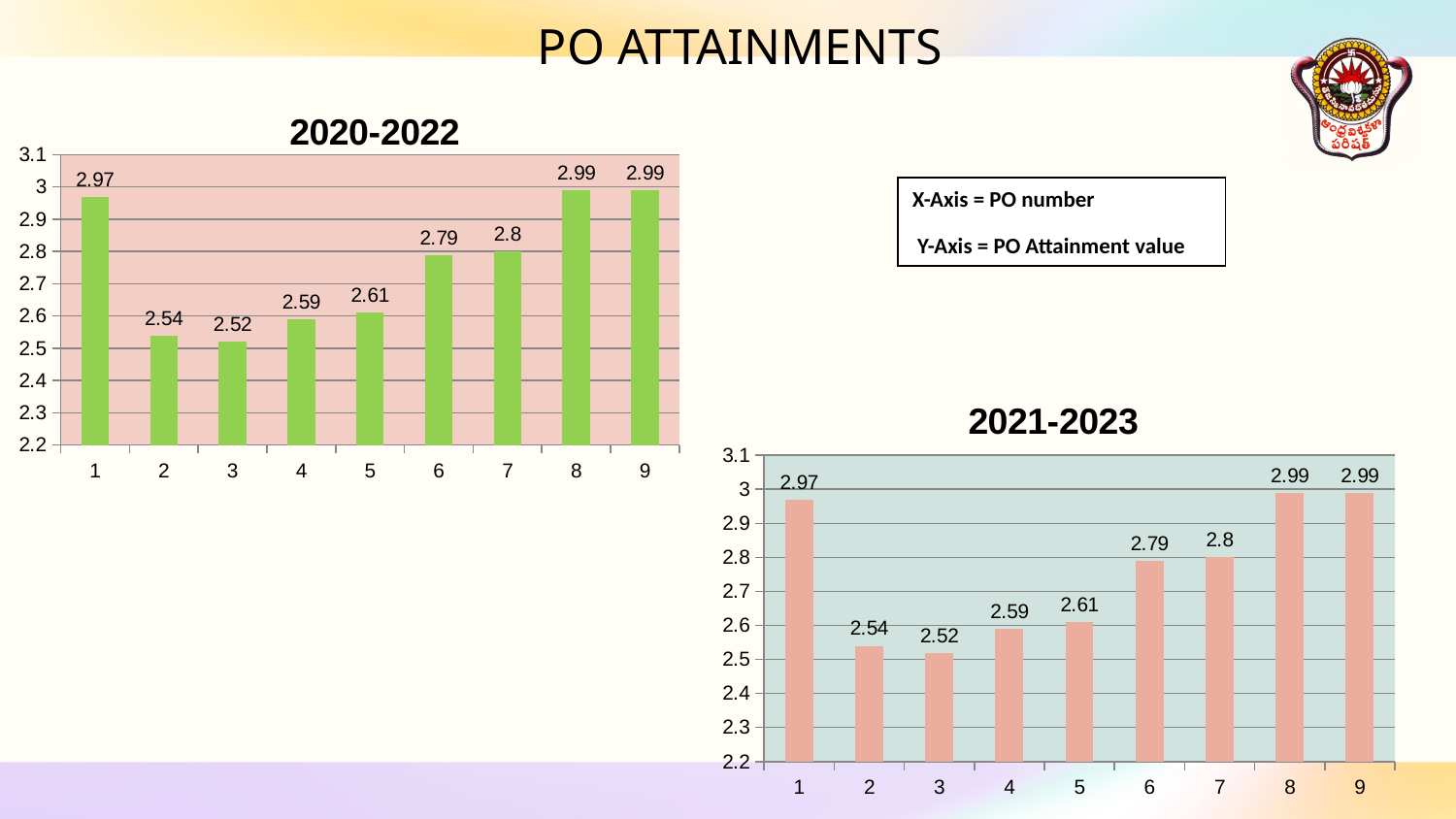
In the 2020-2022 chart, is the value for PO number 7 greater or less than 2.7? greater In the 2021-2023 chart, what is the PO attainment value for PO number 6? 2.79 In the 2020-2022 chart, what is the difference between the values for PO number 8 and PO number 3? 0.47 What colour are the bars in the 2021-2023 chart? Salmon/pink In the 2020-2022 chart, what is the PO attainment value for PO number 1? 2.97 In the 2021-2023 chart, do the values rise or fall from PO number 3 to PO number 8? Rise How many PO numbers are plotted in the 2021-2023 chart? 9 What does the X-axis represent according to the text box on the slide? PO number In the 2020-2022 chart, which PO number has the lowest attainment value? 3 In the 2021-2023 chart, which is larger, the value for PO number 4 or PO number 5? PO number 5 In the 2021-2023 chart, what is the lowest PO attainment value shown? 2.52 What kind of chart is the 2020-2022 chart? Bar chart